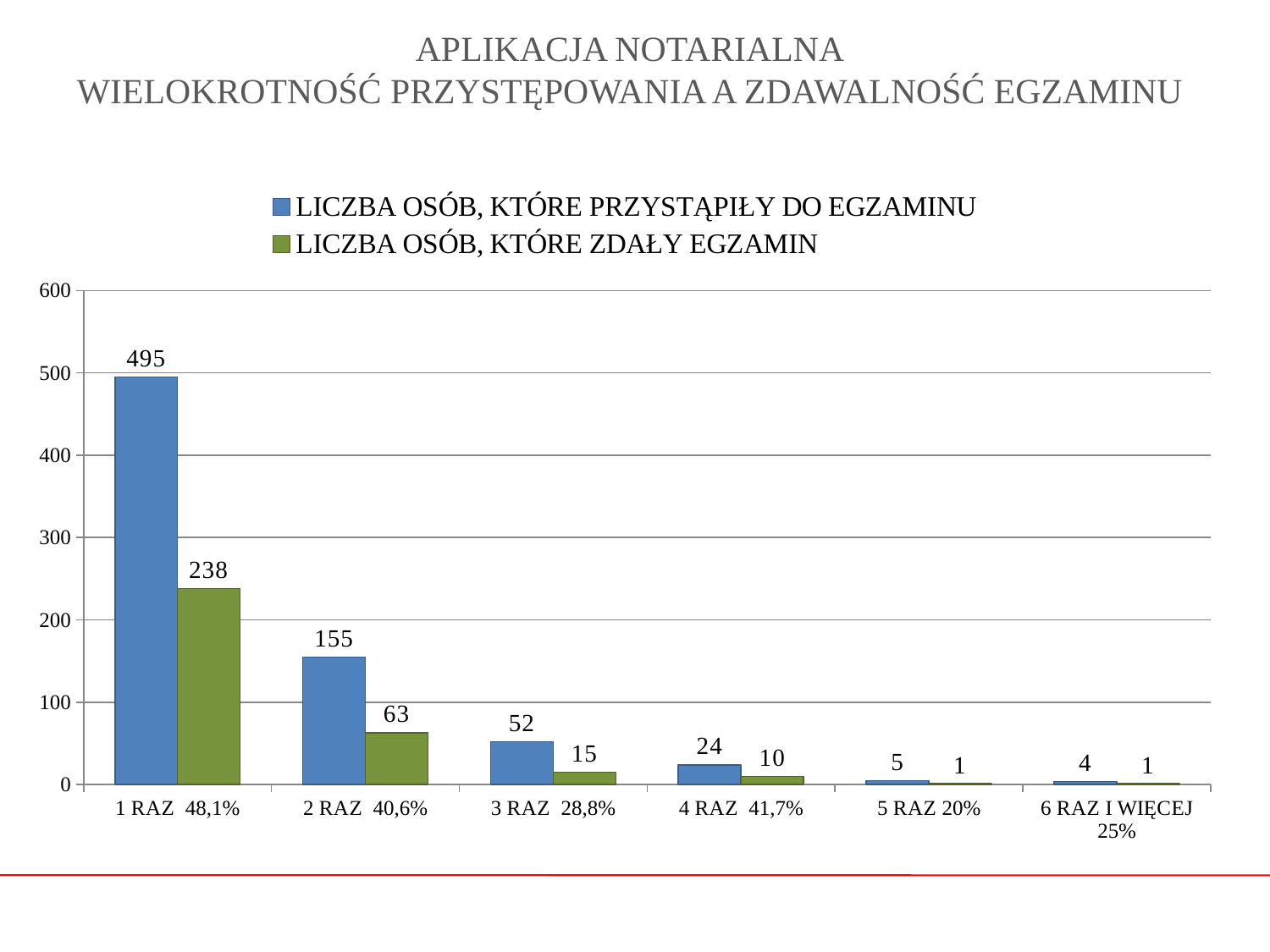
Do the values for LICZBA OSÓB, KTÓRE PRZYSTĄPIŁY DO EGZAMINU rise or fall from left to right along the x axis? Fall Which is larger: the number of people who passed on the 2nd attempt (2 RAZ) or the number who took the exam for the 3rd time (3 RAZ)? 2 RAZ passed (63) How many series does the legend list? 2 How many people passed the exam on their second attempt (2 RAZ)? 63 What pass rate percentage is shown in the x-axis label for the 4 RAZ category? 41,7% How many people took the exam for the first time (1 RAZ) according to the chart? 495 What kind of chart is shown on the slide? Bar chart Which category has the highest number of people who passed the exam? 1 RAZ What is the difference between the number of people who took the exam and the number who passed in the 1 RAZ category? 257 How many categories are shown on the x axis of the chart? 6 Which category has the lowest number of people who took the exam? 6 RAZ I WIĘCEJ What is the value of LICZBA OSÓB, KTÓRE PRZYSTĄPIŁY DO EGZAMINU for the 3 RAZ category? 52